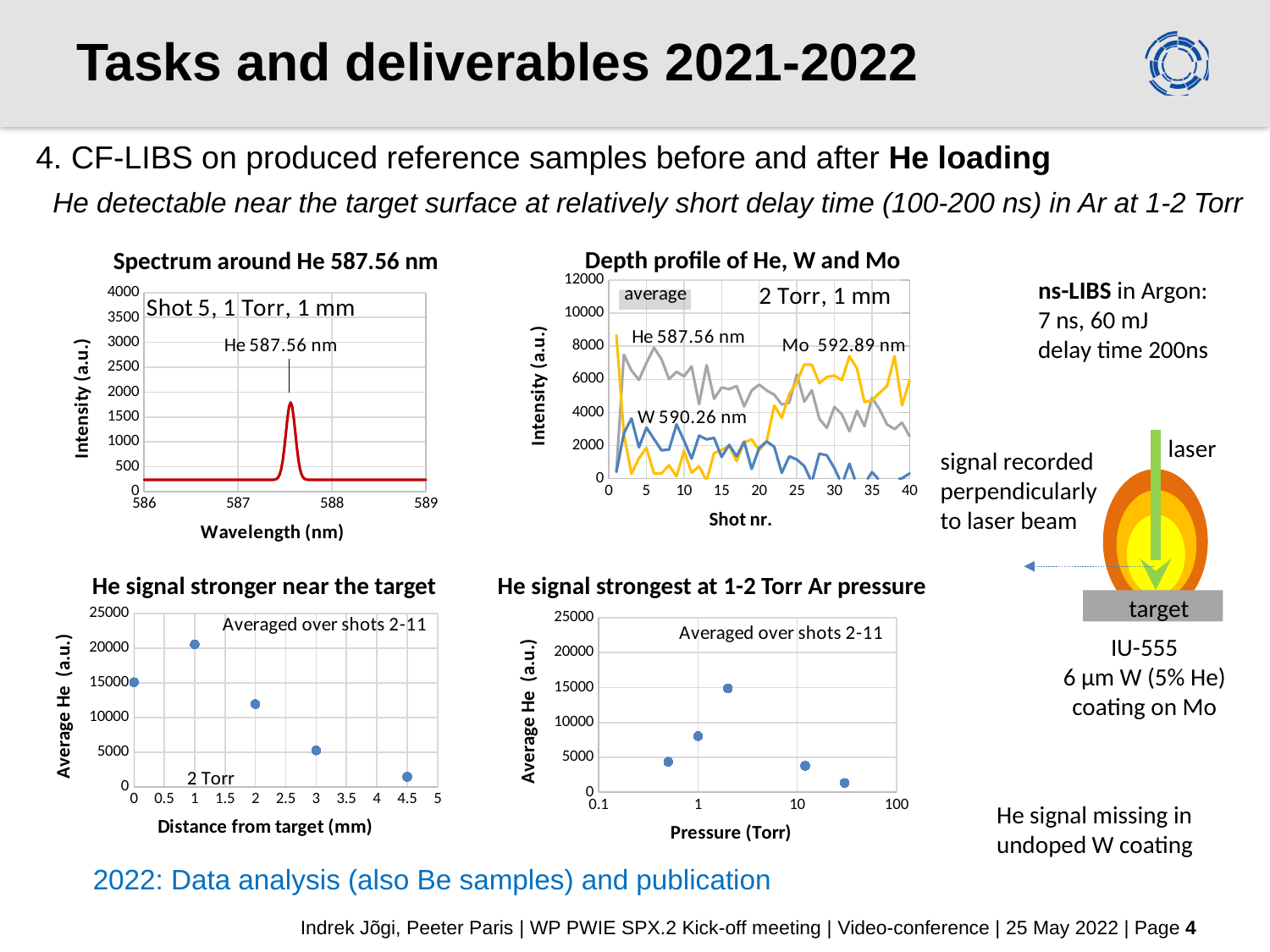
How many data points are plotted in the 'He signal stronger near the target' chart? 5 In the 'Spectrum around He 587.56 nm' chart, is the peak intensity greater or less than 2000? less In the 'Spectrum around He 587.56 nm' chart, is the peak intensity greater or less than 1500? greater In the 'He signal stronger near the target' chart, at which distance from the target is the average He signal highest? 1 mm In the 'He signal strongest at 1-2 Torr Ar pressure' chart, which is larger: the average He at 1 Torr or at 10 Torr? 1 Torr In the 'He signal strongest at 1-2 Torr Ar pressure' chart, at which pressure is the average He signal highest? 2 Torr How many series are plotted in the 'Depth profile of He, W and Mo' chart? 3 In the 'Depth profile of He, W and Mo' chart, which series is labelled 'W 590.26 nm'? the blue line In the 'Depth profile of He, W and Mo' chart, does the Mo 592.89 nm signal rise or fall overall as the shot number increases? rise In the 'Depth profile of He, W and Mo' chart, does the He 587.56 nm signal rise or fall as the shot number increases? fall What kind of chart is the 'Spectrum around He 587.56 nm' chart? line chart